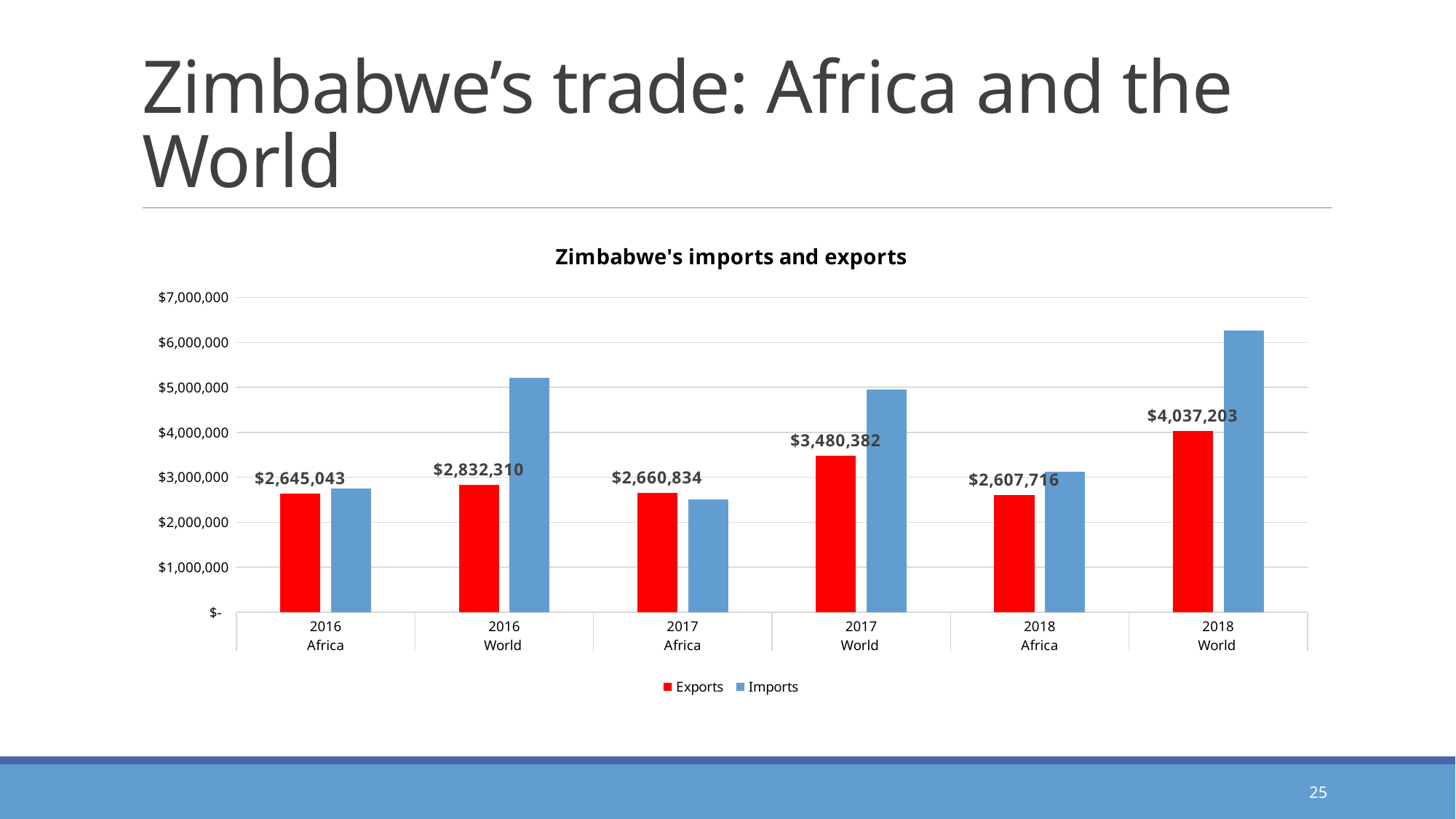
What type of chart is shown on the slide? Bar chart What is the difference between Exports for 2016 World and Exports for 2016 Africa? $187,267 Is the Imports value for 2018 World greater or less than $6,000,000? greater What is the value of Exports for 2018 World? $4,037,203 For 2017 Africa, which is larger, Exports or Imports? Exports Which category has the lowest Exports value? 2018 Africa What is the difference between Exports for 2018 World and Exports for 2017 World? $556,821 What is the value of Exports for 2016 Africa? $2,645,043 Is the Imports value for 2016 World greater or less than $5,000,000? greater How many series does the legend list? 2 Which category has the highest Exports value? 2018 World How many categories are shown on the x axis? 6